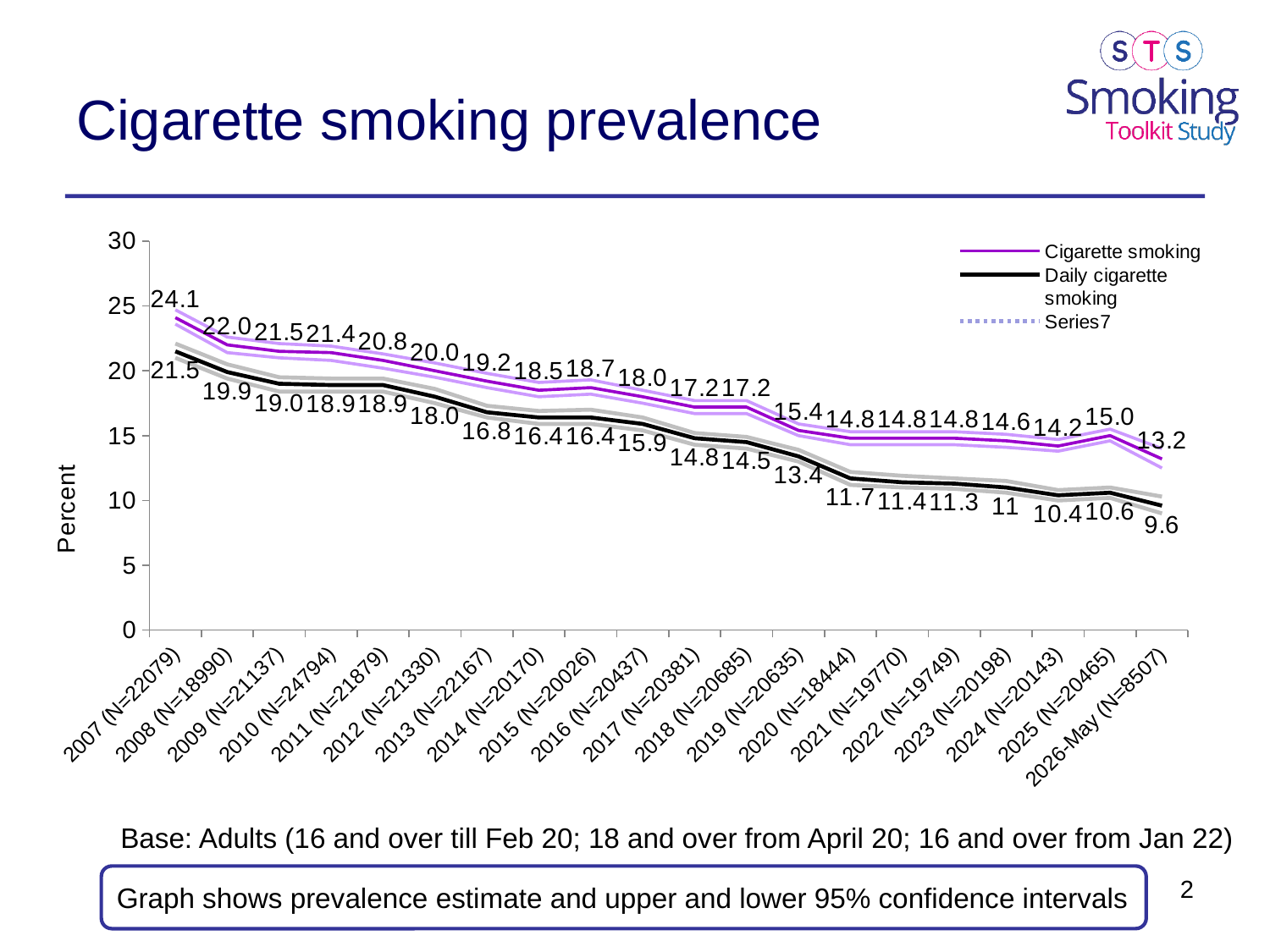
What is the daily cigarette smoking prevalence for 2026-May (N=8507)? 9.6 What is the difference between cigarette smoking and daily cigarette smoking prevalence in 2020 (N=18444)? 3.1 What kind of chart is shown on the slide? Line chart How many years (categories) are shown on the x axis? 20 What is the cigarette smoking prevalence for 2007 (N=22079)? 24.1 Which is larger: cigarette smoking prevalence in 2025 (N=20465) or in 2024 (N=20143)? 2025 (N=20465) Does the cigarette smoking prevalence generally rise or fall from 2007 to 2026-May? Fall What is the daily cigarette smoking prevalence for 2013 (N=22167)? 16.8 How many series does the legend list? 3 Which year has the lowest daily cigarette smoking prevalence? 2026-May (N=8507) Which year has the highest cigarette smoking prevalence? 2007 (N=22079) What is the cigarette smoking prevalence for 2019 (N=20635)? 15.4